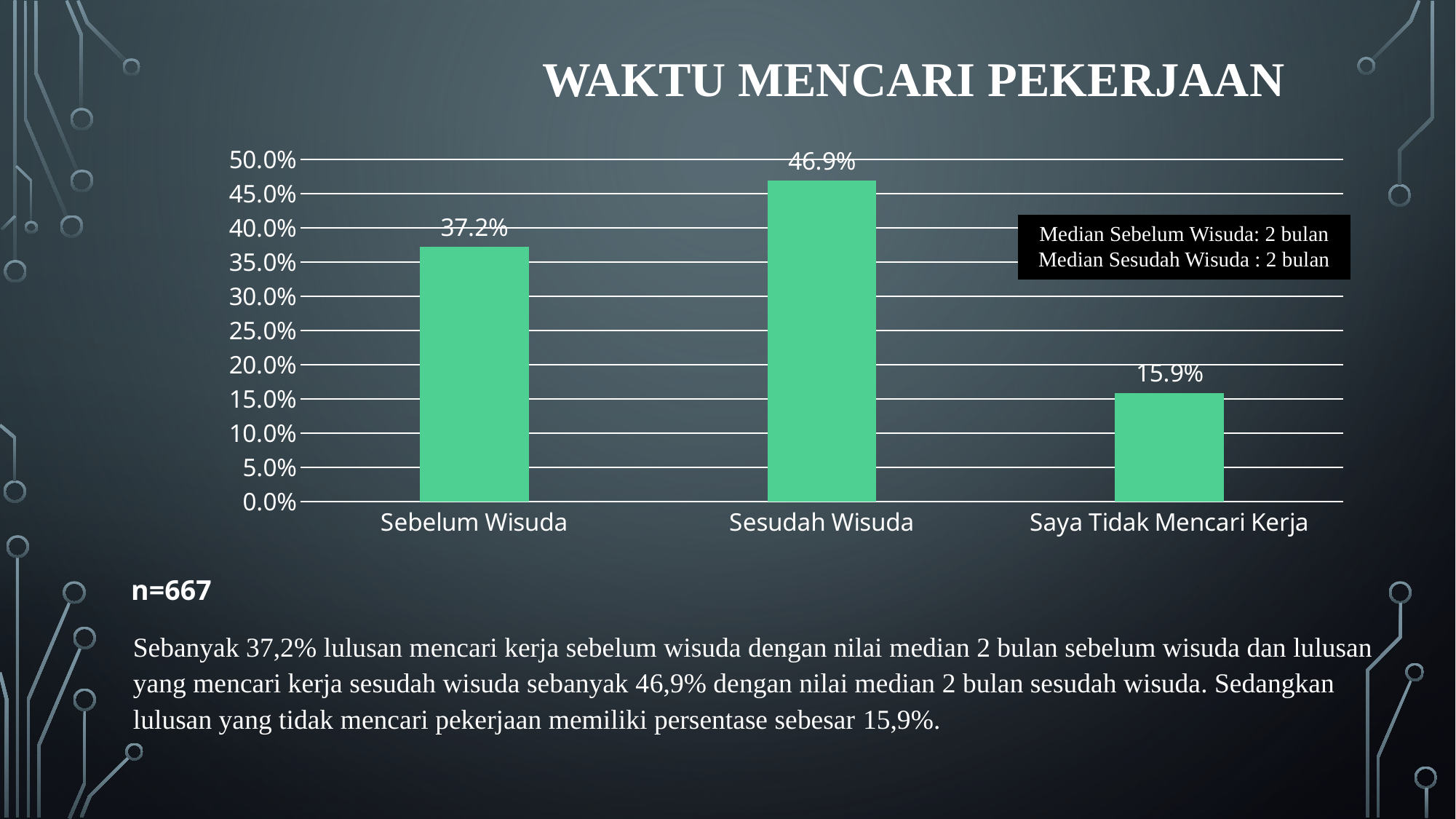
What is the value for Saya Tidak Mencari Kerja? 15.9% What is the value for Sesudah Wisuda? 46.9% Which is larger, the value for Sebelum Wisuda or the value for Saya Tidak Mencari Kerja? Sebelum Wisuda How many categories are shown on the x axis? 3 What is the difference between the values for Sesudah Wisuda and Sebelum Wisuda? 9.7% Is the value for Sesudah Wisuda greater or less than 45.0%? greater What is the value for Sebelum Wisuda? 37.2% Which category has the lowest value? Saya Tidak Mencari Kerja What is the difference between the values for Sebelum Wisuda and Saya Tidak Mencari Kerja? 21.3% What is the title of the chart? WAKTU MENCARI PEKERJAAN Which category has the highest value? Sesudah Wisuda What kind of chart is shown on the slide? bar chart